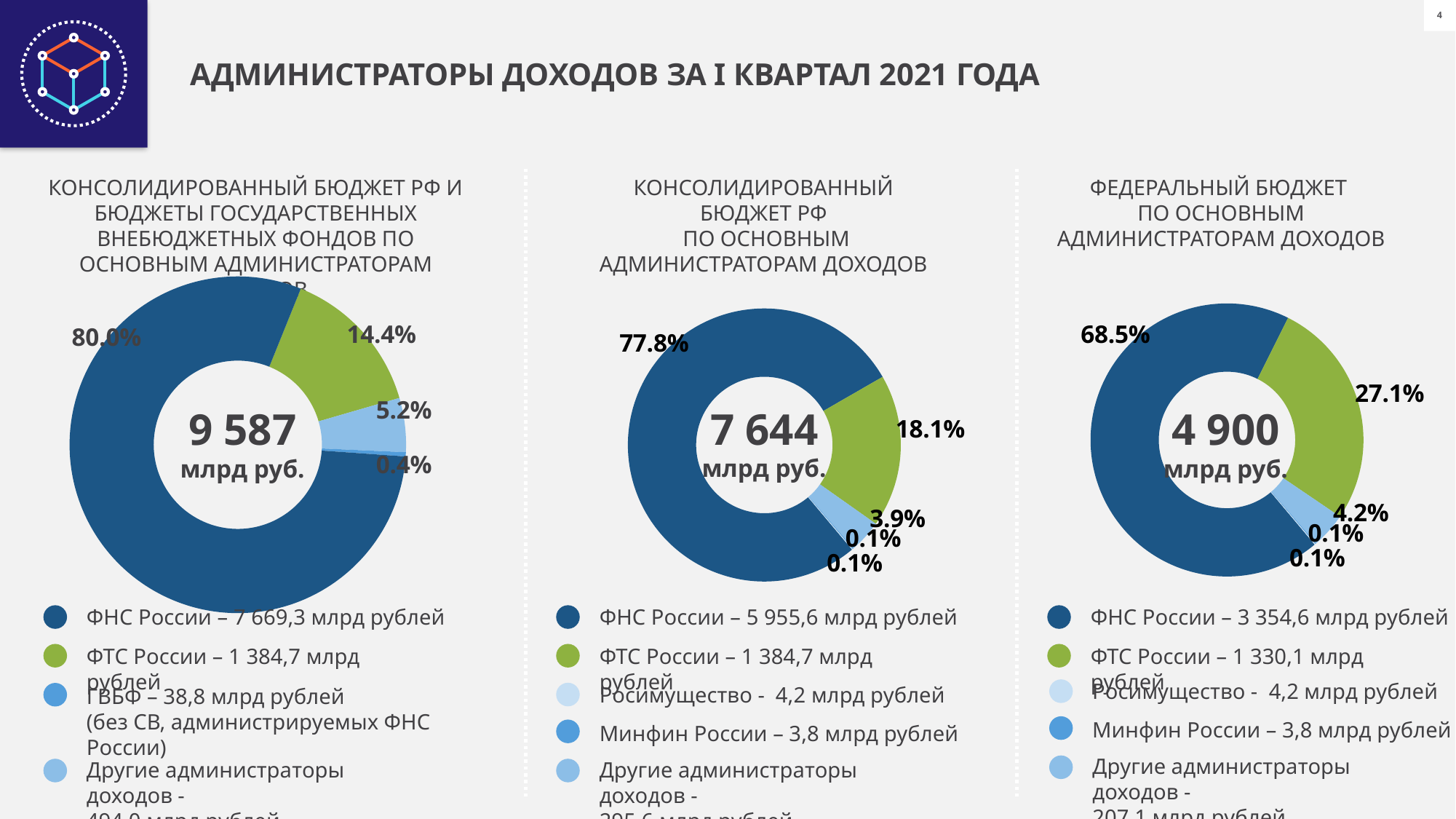
What total value is shown in the centre of the middle chart (Консолидированный бюджет РФ)? 7 644 млрд руб. In the middle chart (Консолидированный бюджет РФ по основным администраторам доходов), what share does ФТС России hold? 18.1% In the middle chart, which is larger: the share of ФТС России or the share of Другие администраторы доходов? ФТС России In the right chart (Федеральный бюджет по основным администраторам доходов), what share does ФНС России hold? 68.5% In the right chart, what is the difference between the ФНС России share and the ФТС России share? 41.4% In the left chart, which administrator has the smallest share? ГВБФ (0.4%) In the left chart (Консолидированный бюджет РФ и бюджеты государственных внебюджетных фондов), what share does ФНС России hold? 80.0% In the right chart, which administrator has the largest share? ФНС России According to the legend of the right chart, what is the value for ФТС России? 1 330,1 млрд рублей What total value is shown in the centre of the right chart (Федеральный бюджет)? 4 900 млрд руб. How many slices does the middle chart (Консолидированный бюджет РФ) contain? 5 What kind of chart is used on this slide for the three budget breakdowns? Donut (pie) chart